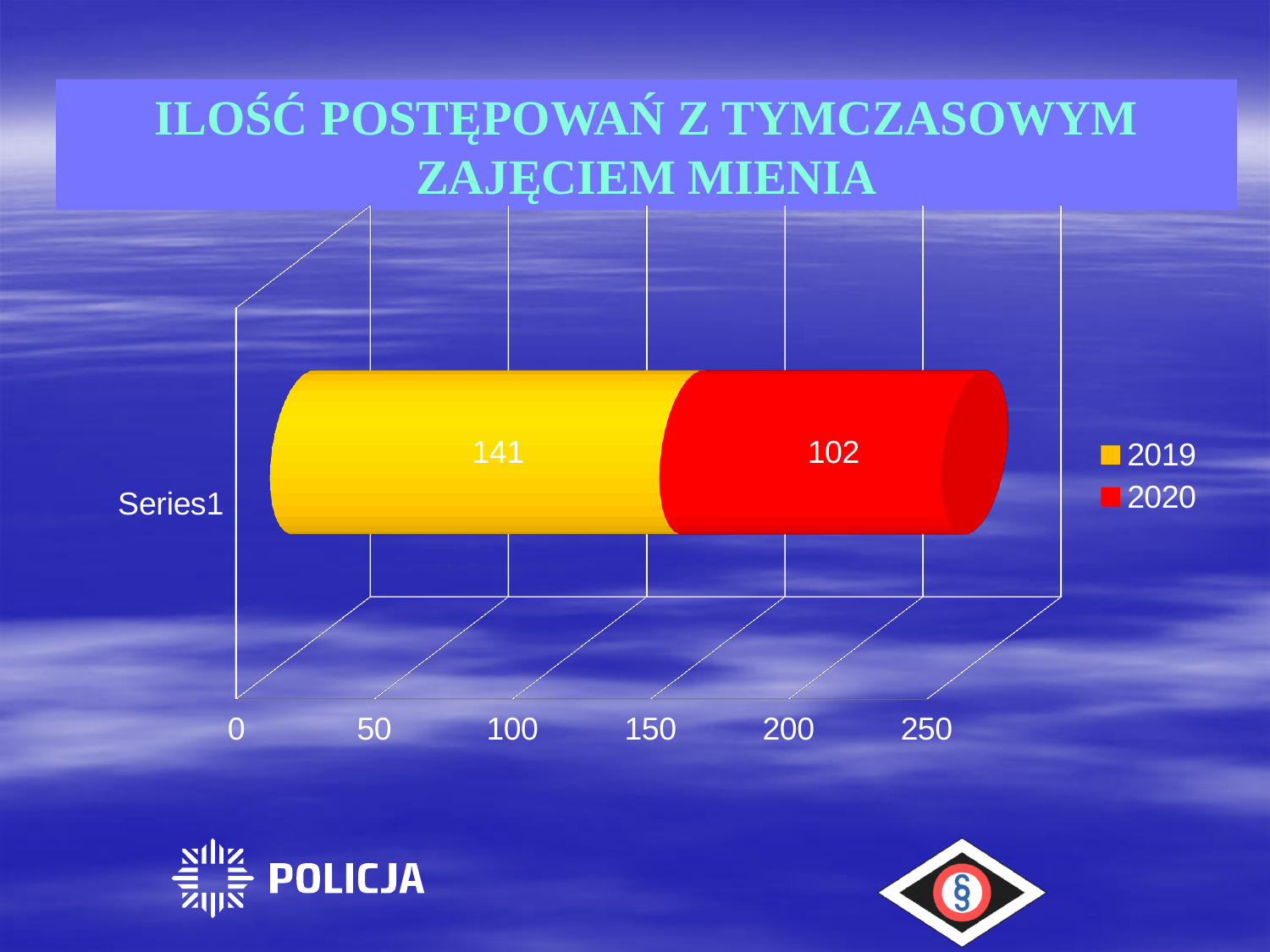
What is the total of the stacked bar for Series1? 243 Which series has the lowest value in the chart? 2020 What kind of chart is shown on the slide? Stacked bar chart Is the value for 2019 greater or less than 150? less What is the value for 2019 in the chart? 141 How many series does the legend list? 2 Which year has the higher value, 2019 or 2020? 2019 Is the value for 2020 greater or less than 100? greater What is the difference between the 2019 and 2020 values? 39 What is the title of the chart? ILOŚĆ POSTĘPOWAŃ Z TYMCZASOWYM ZAJĘCIEM MIENIA What is the value for 2020 in the chart? 102 What colour represents 2020 in the chart? Red